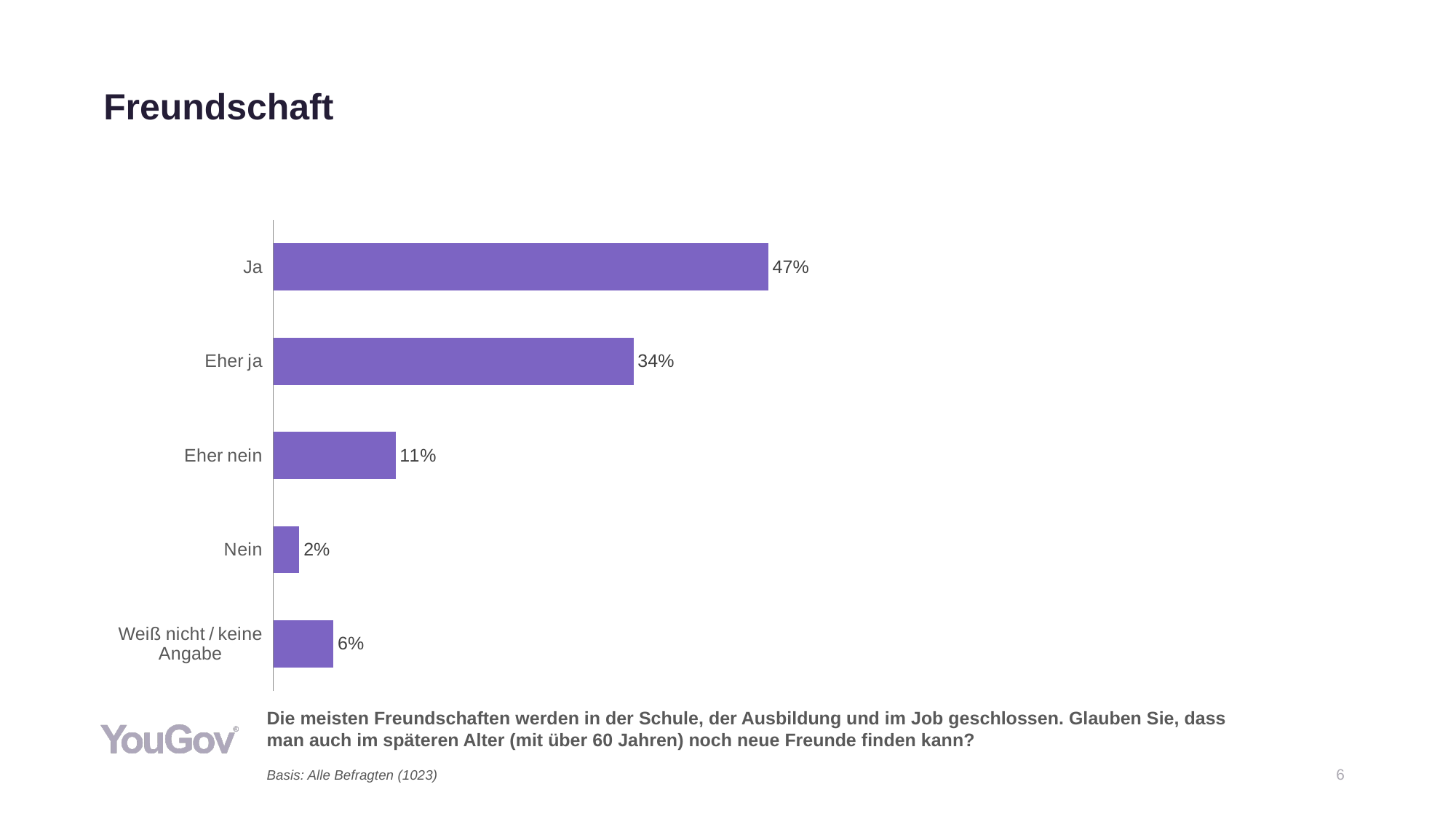
Which is larger, the value for "Nein" or the value for "Weiß nicht / keine Angabe"? Weiß nicht / keine Angabe What is the difference between the values for "Ja" and "Eher ja"? 13% What percentage of respondents answered "Ja"? 47% What is the difference between the values for "Eher nein" and "Nein"? 9% What is the value for "Weiß nicht / keine Angabe"? 6% How many categories are shown in the chart? 5 What is the value shown for "Eher ja"? 34% Which category has the highest value? Ja What percentage is shown for "Eher nein"? 11% What is the title of the slide containing the chart? Freundschaft What kind of chart is shown on the slide? Bar chart Which category has the lowest value? Nein